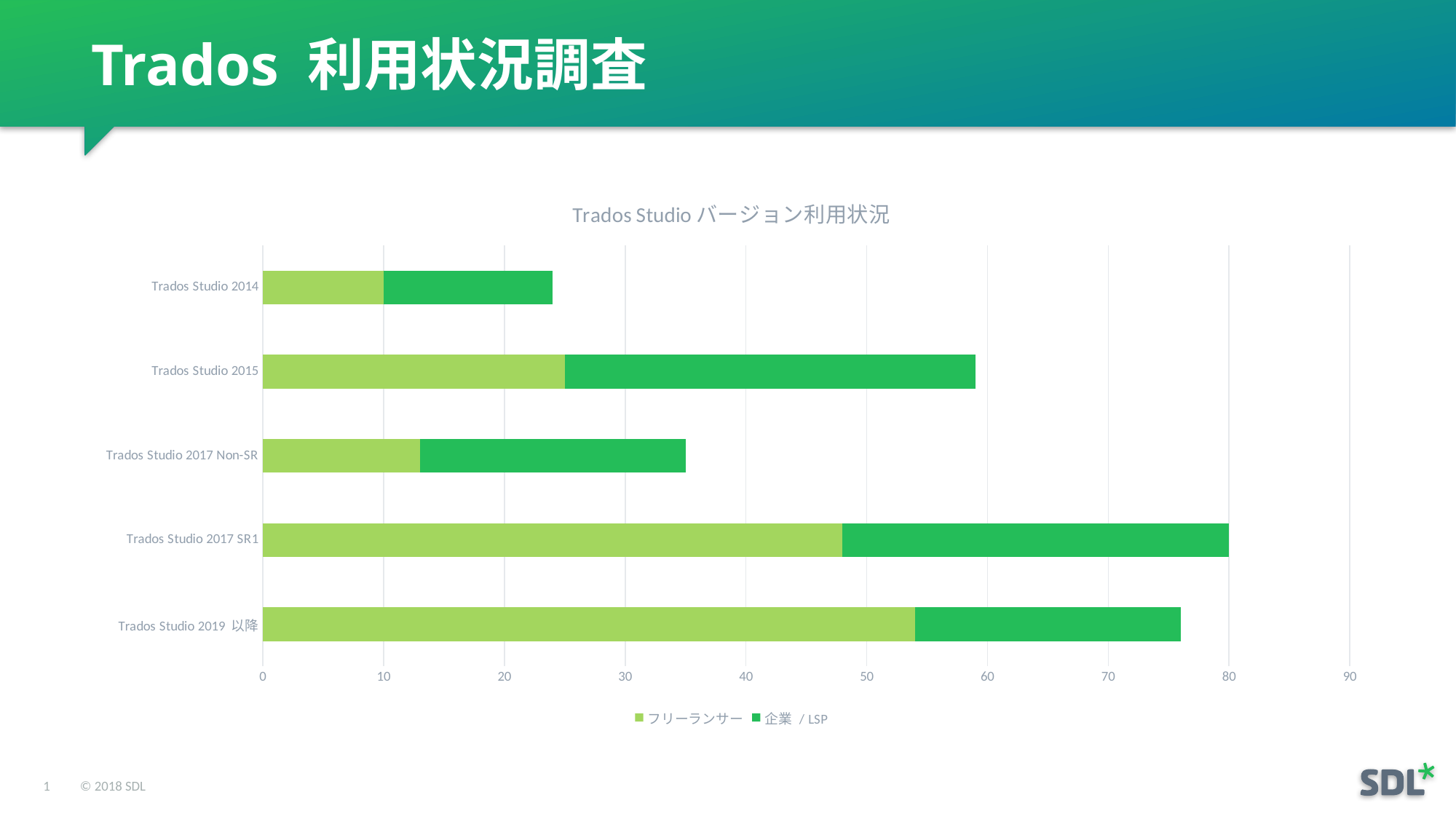
Which version has the longest total bar? Trados Studio 2017 SR1 What is the title of the chart? Trados Studio バージョン利用状況 How many series does the legend list? 2 How many Trados Studio versions (categories) are plotted in the chart? 5 Is the フリーランサー value for Trados Studio 2019 以降 greater or less than 50? greater Is the フリーランサー value for Trados Studio 2017 Non-SR greater or less than 20? less Is the フリーランサー value for Trados Studio 2017 SR1 greater or less than 40? greater Which has the longer total bar, Trados Studio 2015 or Trados Studio 2017 Non-SR? Trados Studio 2015 Which version has the largest フリーランサー segment? Trados Studio 2019 以降 Which version has the shortest total bar? Trados Studio 2014 What kind of chart is shown on the slide? stacked bar chart